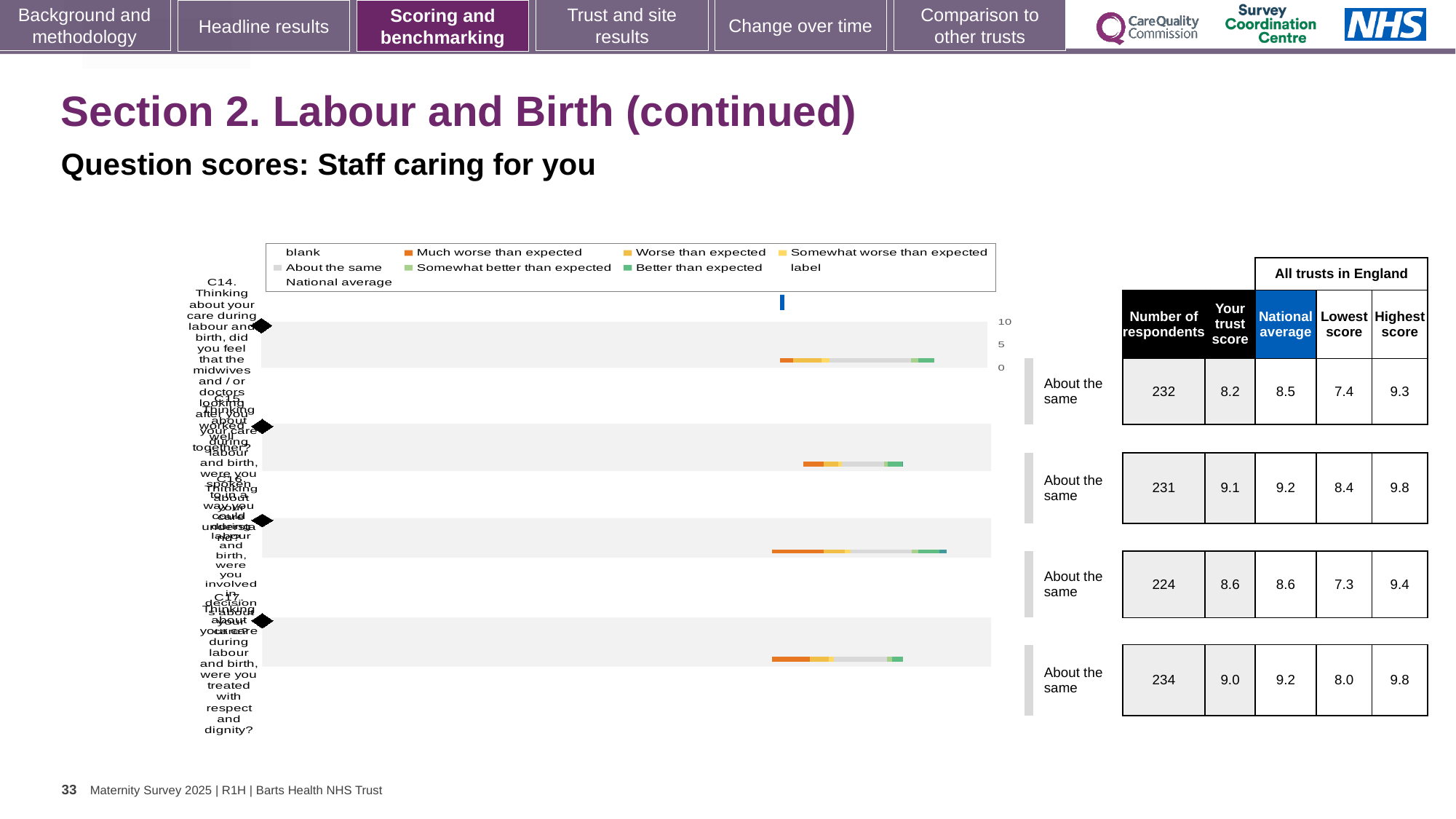
How many entries does the chart legend list? 9 How many question rows (bars) does the chart show? 4 In the table beside the chart, what is the difference between the national average and the trust score for the first row (C14)? 0.3 In the table beside the chart, what is the national average for the third row (C16)? 8.6 In the table beside the chart, is the trust score for the fourth row (C17) higher or lower than its national average? lower Which legend entry is shown in dark green in the chart? Better than expected What kind of chart is shown on the slide? bar chart Which legend entry is shown in orange in the chart? Much worse than expected In the table beside the chart, what is the trust score for the second row (C15)? 9.1 In the table beside the chart, what is the highest score for the fourth row (C17)? 9.8 In the table beside the chart, what is the number of respondents for the first row (C14)? 232 In the table beside the chart, which row has the highest trust score? C15 (9.1)